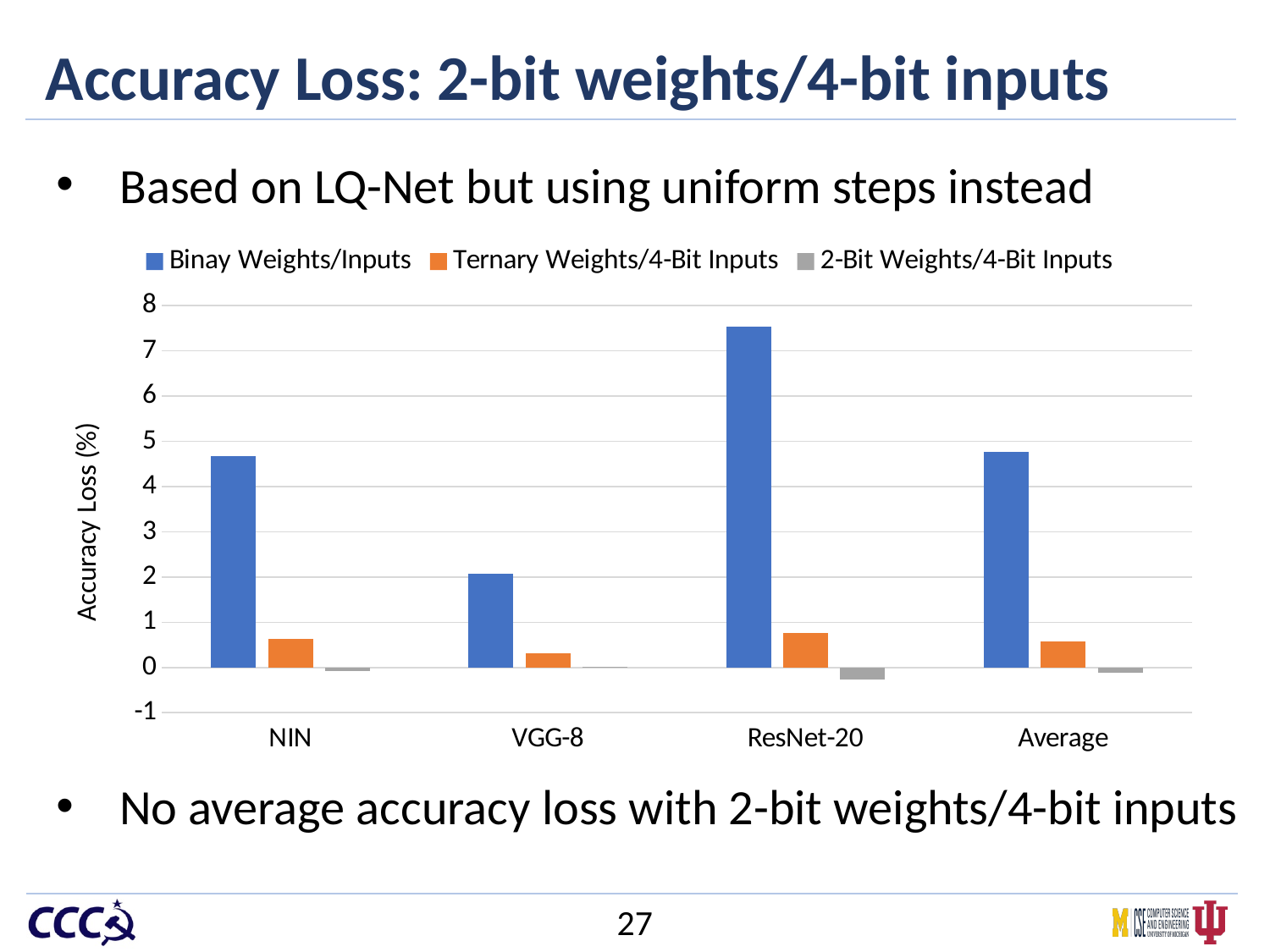
Which category has the lowest value for the Ternary Weights/4-Bit Inputs series? VGG-8 Which category has the highest value for the Binay Weights/Inputs series? ResNet-20 Is the Binay Weights/Inputs value for ResNet-20 greater or less than 7? greater Which category has the lowest value for the Binay Weights/Inputs series? VGG-8 Is the Ternary Weights/4-Bit Inputs value for NIN greater or less than 1? less What is the label on the y axis of the chart? Accuracy Loss (%) For ResNet-20, which series has the larger value: Ternary Weights/4-Bit Inputs or 2-Bit Weights/4-Bit Inputs? Ternary Weights/4-Bit Inputs How many series does the chart legend list? 3 How many categories are shown on the x axis of the chart? 4 For the Binay Weights/Inputs series, which is larger: NIN or VGG-8? NIN Is the Binay Weights/Inputs value for VGG-8 greater or less than 3? less What kind of chart is shown on the slide? bar chart